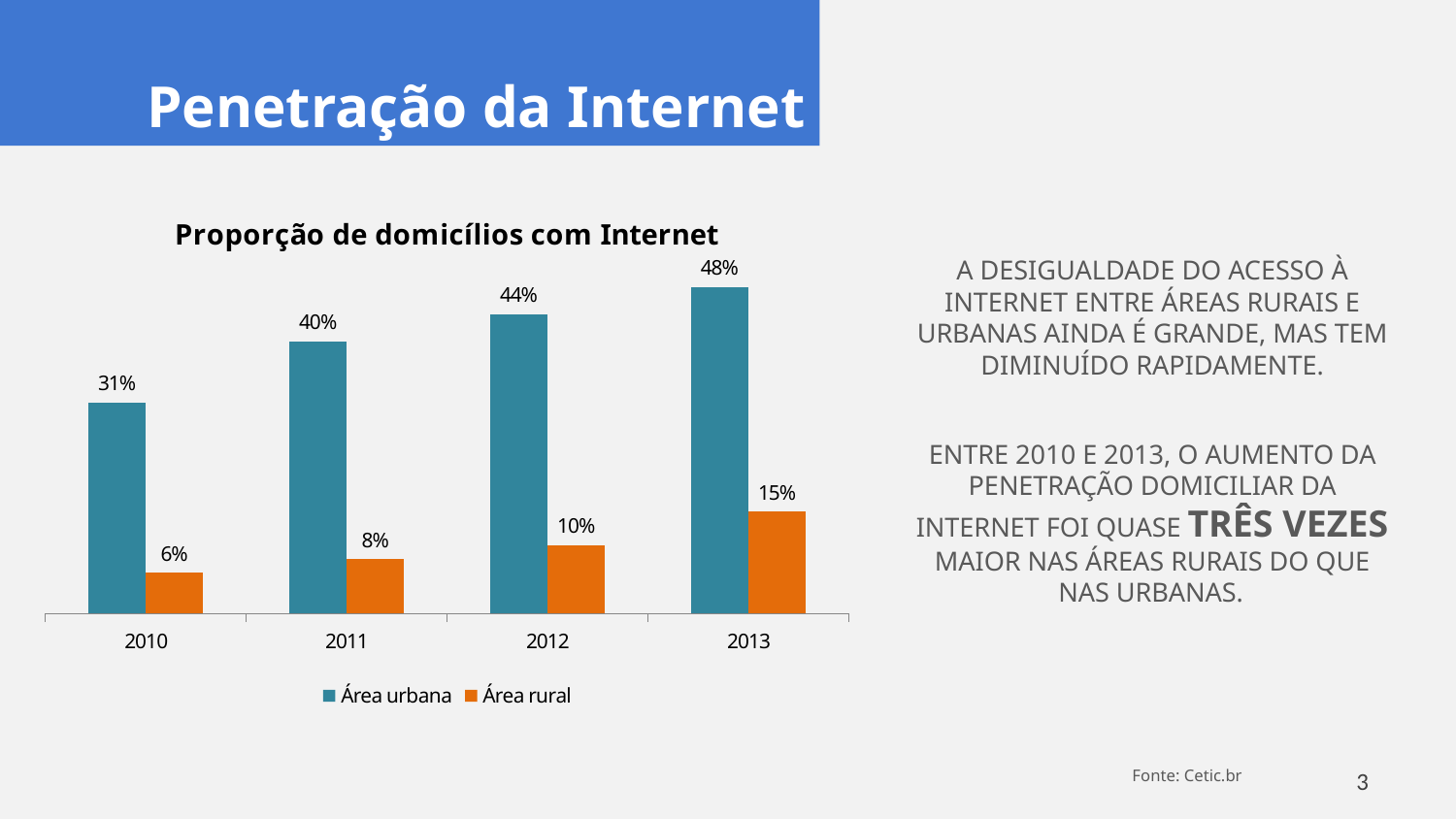
What is the value for Área urbana in 2010? 31% By how much did the Área rural value increase from 2010 to 2013? 9% What is the difference between Área urbana and Área rural in 2012? 34% In which year is the Área urbana value highest? 2013 What is the value for Área rural in 2013? 15% How many years are shown on the x axis? 4 What kind of chart is shown? Bar chart Which is larger: Área urbana in 2011 or Área urbana in 2012? Área urbana in 2012 What is the value for Área rural in 2011? 8% In which year is the Área rural value lowest? 2010 Do the Área urbana values rise or fall from 2010 to 2013? Rise How many series does the legend list? 2